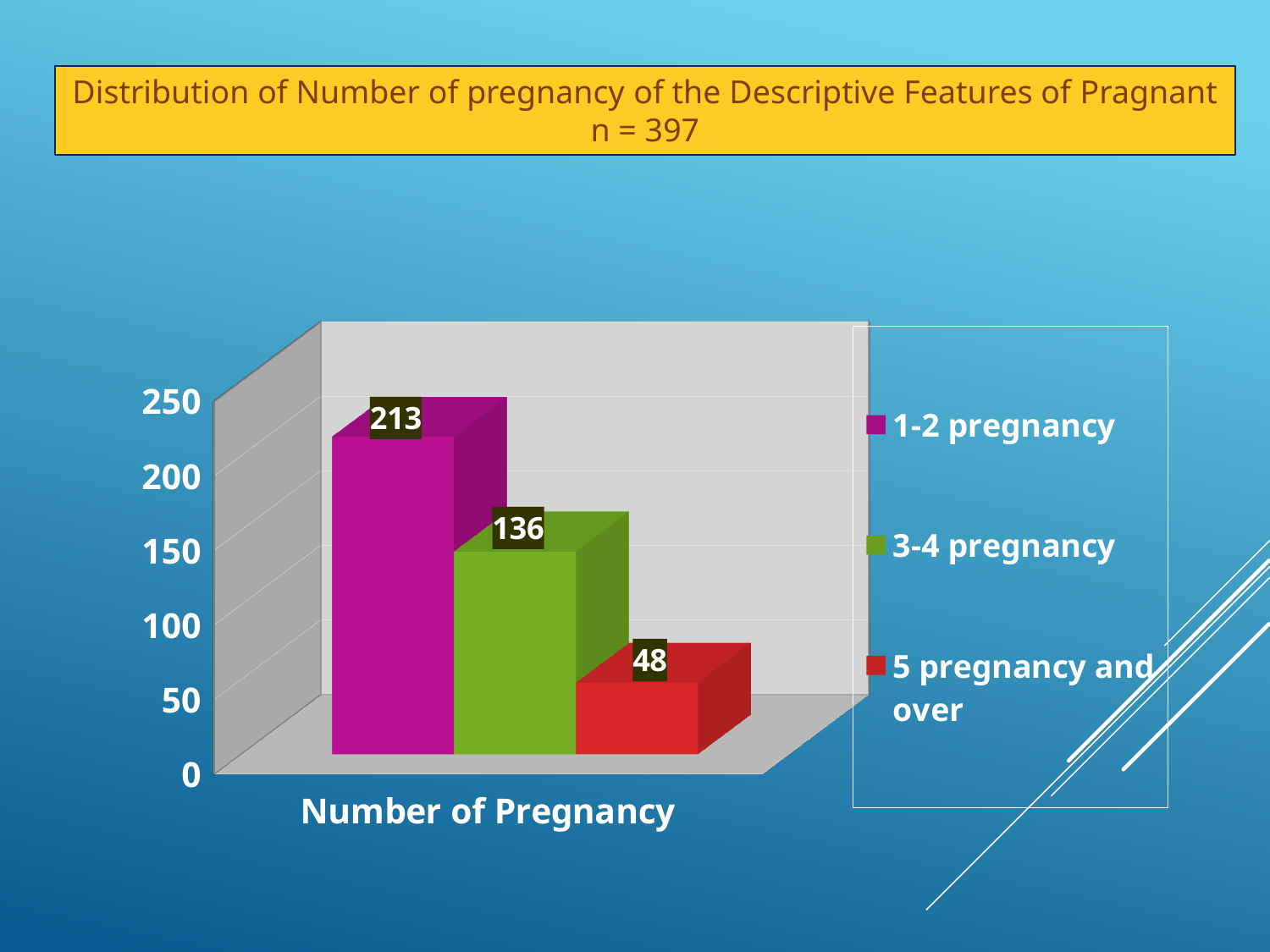
What is the value for 1-2 pregnancy? 213 Which category has the highest value? 1-2 pregnancy How many series does the legend list? 3 Which category has the lowest value? 5 pregnancy and over Is the value for 1-2 pregnancy greater or less than 200? greater What is the difference between the values for 1-2 pregnancy and 3-4 pregnancy? 77 What is the label on the horizontal axis of the chart? Number of Pregnancy Which is larger, the value for 3-4 pregnancy or the value for 5 pregnancy and over? 3-4 pregnancy What is the value for 3-4 pregnancy? 136 What is the difference between the values for 3-4 pregnancy and 5 pregnancy and over? 88 What kind of chart is shown on the slide? bar chart What is the value for 5 pregnancy and over? 48